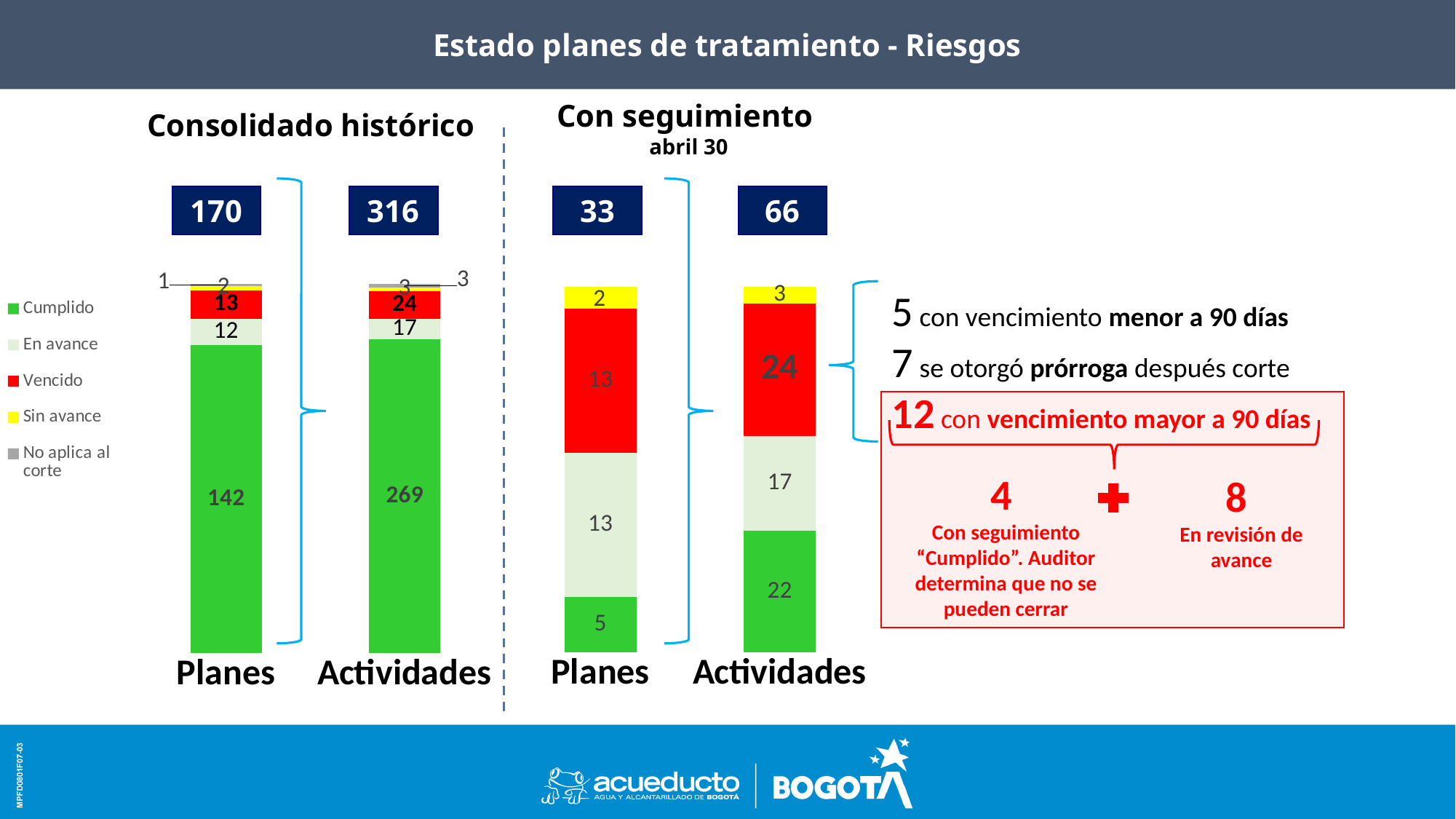
In the 'Consolidado histórico' chart, what is the Cumplido value for Planes? 142 In the 'Con seguimiento' chart, what is the Cumplido value for Planes? 5 In the 'Consolidado histórico' chart, what is the Vencido value for Actividades? 24 In the 'Con seguimiento' chart, is the Cumplido value larger for Planes or for Actividades? Actividades Which colour represents Vencido in the legend? Red What type of chart is used on this slide? Stacked bar chart In the 'Consolidado histórico' chart, what is the total shown for the Actividades bar? 316 In the 'Con seguimiento' chart, what is the En avance value for Actividades? 17 How many series does the legend list? 5 In the 'Consolidado histórico' chart, what is the difference between the Cumplido values for Actividades and Planes? 127 In the 'Con seguimiento' chart, what is the total shown for the Planes bar? 33 In the 'Con seguimiento' chart, which segment of the Actividades bar is the largest? Vencido